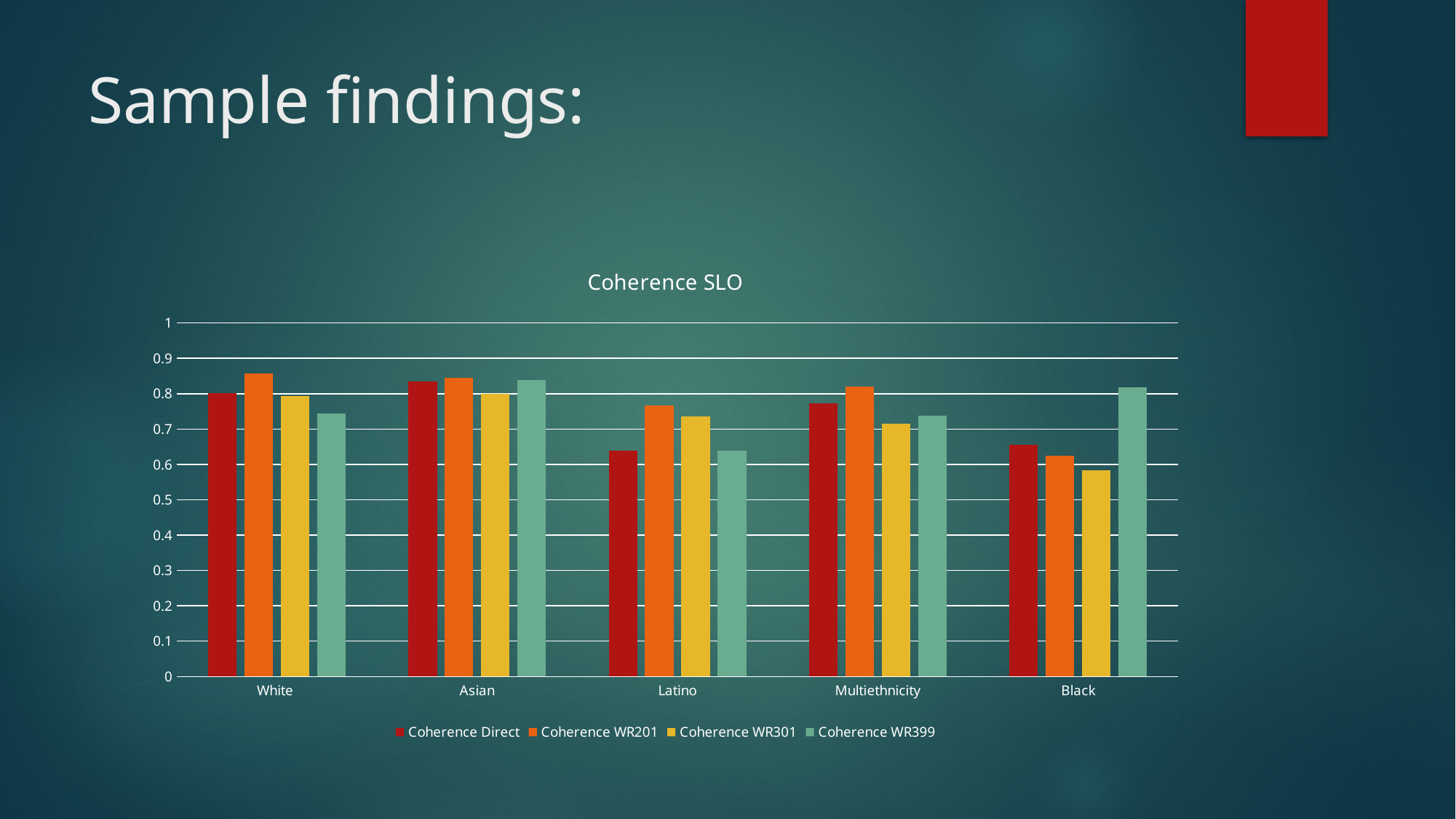
Which category has the lowest value for Coherence WR399? Latino Which category has the lowest value for Coherence WR301? Black Which category has the lowest value for Coherence WR201? Black What kind of chart is shown on the slide? bar chart Is the value for Coherence WR201 for White greater or less than 0.8? greater For Black, which is larger: Coherence Direct or Coherence WR399? Coherence WR399 What is the title of the chart? Coherence SLO How many series does the legend list? 4 For Latino, which is larger: Coherence Direct or Coherence WR201? Coherence WR201 Is the value for Coherence Direct for Latino greater or less than 0.7? less How many categories are shown on the x axis? 5 Which series is shown in the dark red colour? Coherence Direct